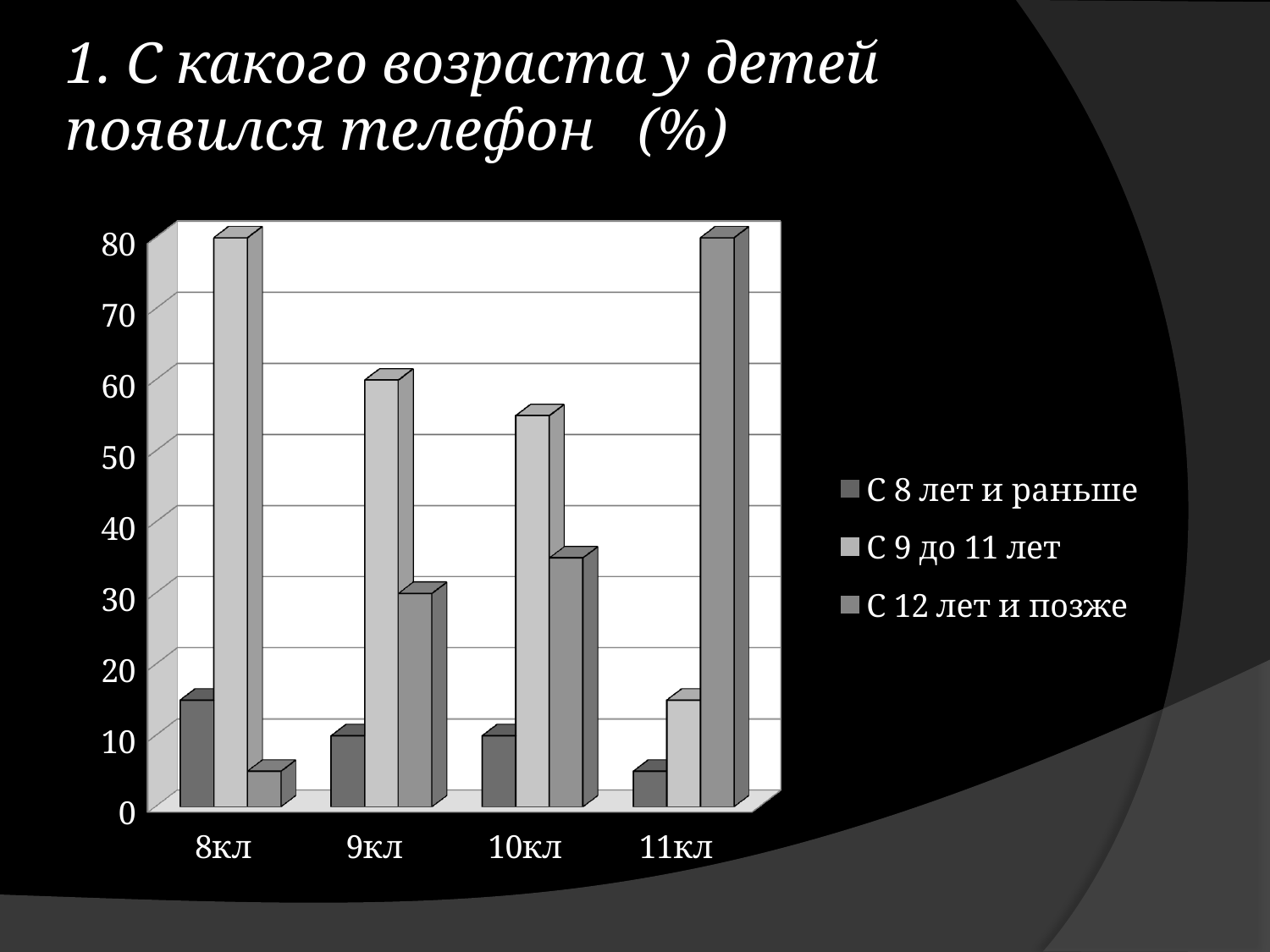
Which is larger in 9кл: the value for "С 9 до 11 лет" or the value for "С 12 лет и позже"? С 9 до 11 лет Does the value for "С 12 лет и позже" rise or fall from 8кл to 11кл? rise Is the value for "С 9 до 11 лет" in 8кл greater or less than 70? greater Which class has the highest value for the series "С 12 лет и позже"? 11кл How many class categories are shown on the x axis? 4 Which class has the highest value for the series "С 9 до 11 лет"? 8кл What kind of chart is shown on the slide? bar chart Is the value for "С 12 лет и позже" in 10кл greater or less than 30? greater Which class has the lowest value for the series "С 12 лет и позже"? 8кл Which class has the lowest value for the series "С 9 до 11 лет"? 11кл Is the value for "С 8 лет и раньше" in 11кл greater or less than 10? less How many series does the legend list? 3